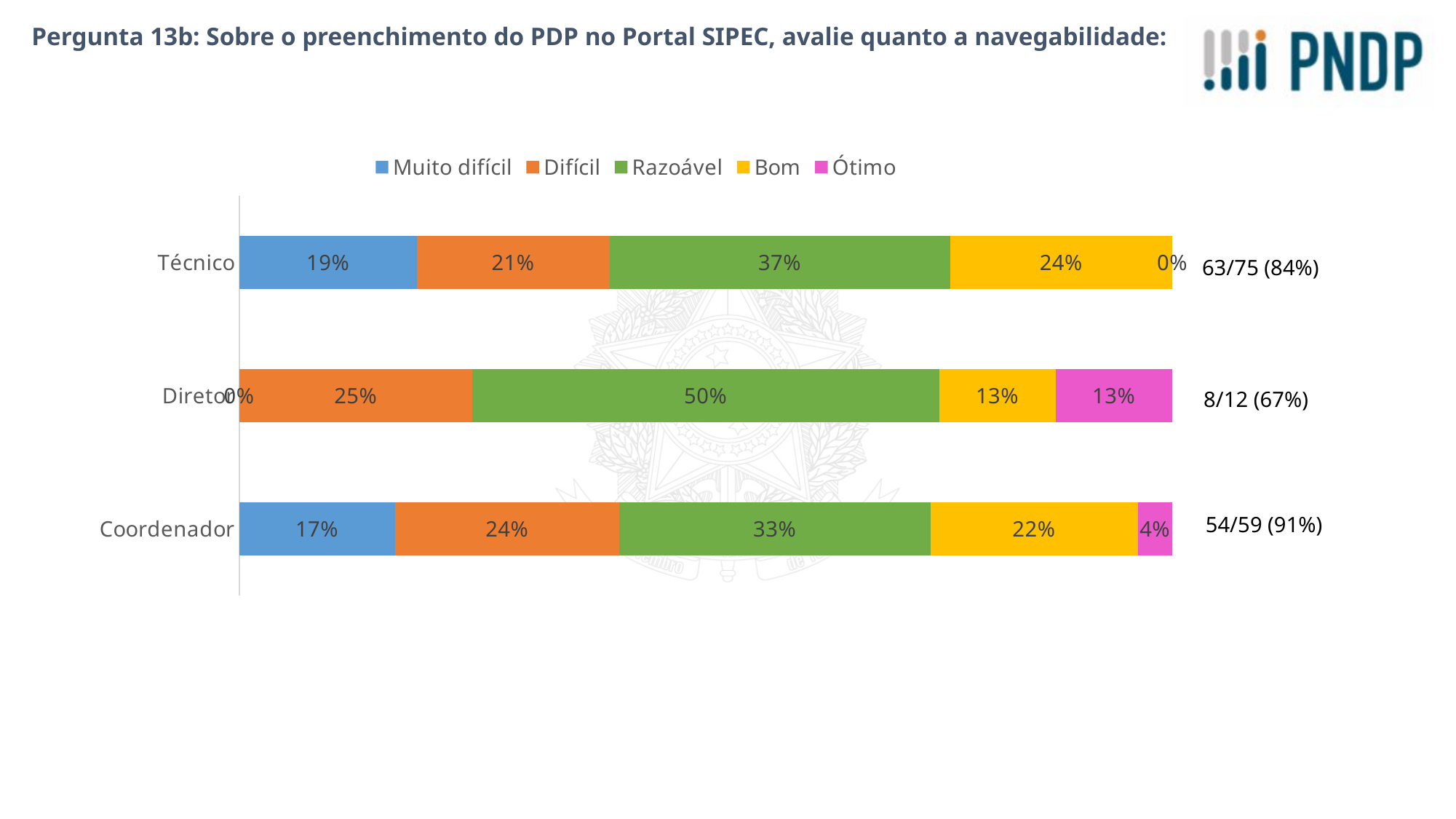
What is the value for Razoável in the Diretor bar? 50% What kind of chart is shown on the slide? Stacked bar chart What response count annotation is shown next to the Coordenador bar? 54/59 (91%) What is the value for Ótimo in the Coordenador bar? 4% Which is larger: the Muito difícil value for Técnico or for Coordenador? Técnico How many series does the legend list? 5 How many categories are plotted on the chart? 3 Which category has the highest value for Razoável? Diretor Which category has the lowest value for Bom? Diretor What is the difference between the Difícil values for Diretor and Técnico? 4% What is the value for Bom in the Técnico bar? 24% What is the value for Muito difícil in the Técnico bar? 19%